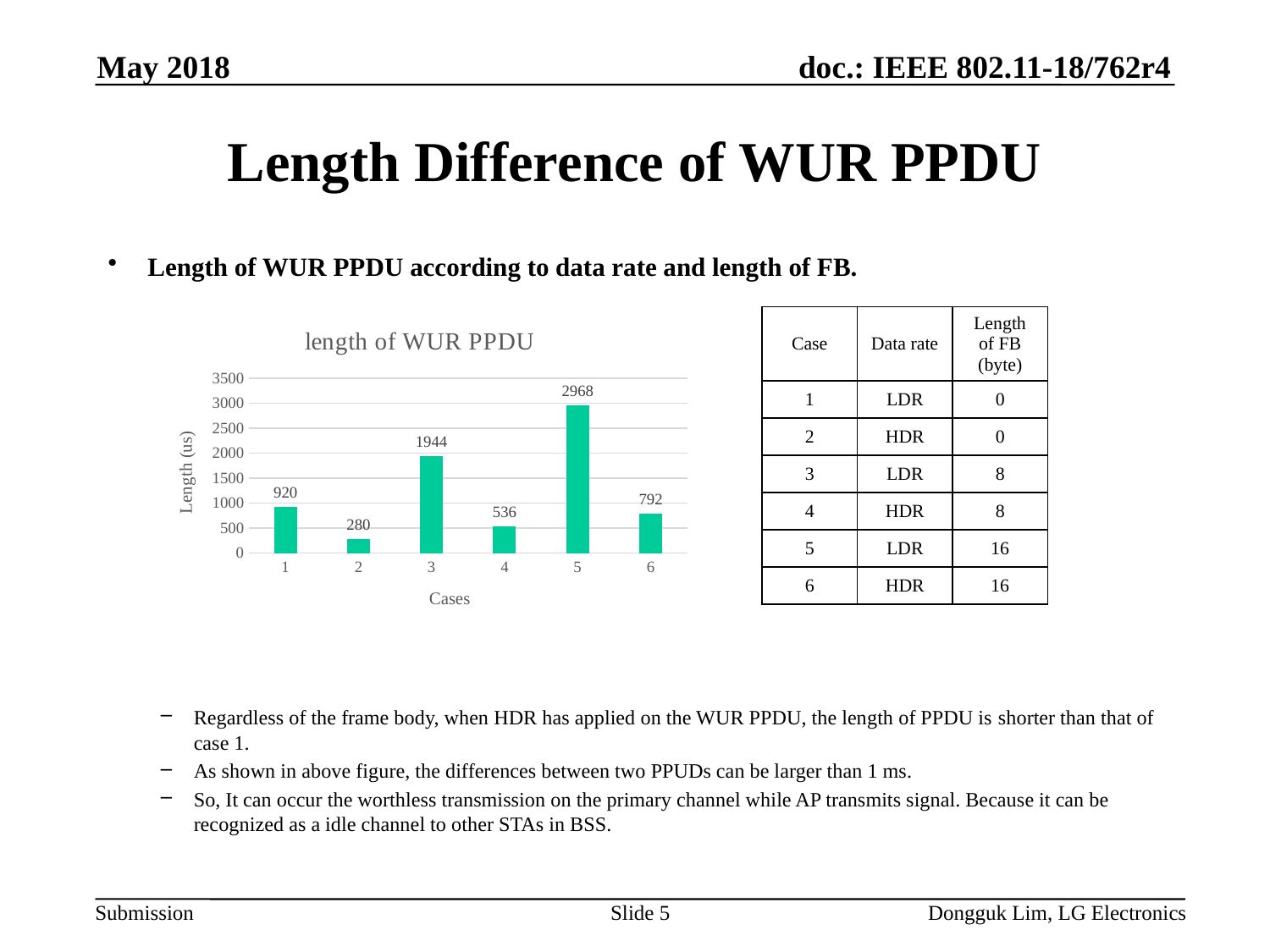
What is the length of WUR PPDU for case 3? 1944 What is the length of WUR PPDU for case 2? 280 Is the value for case 4 greater or less than 1000? less How many cases are plotted in the chart? 6 Which has a larger length of WUR PPDU, case 1 or case 6? case 1 What is the length of WUR PPDU for case 5? 2968 Which case has the lowest length of WUR PPDU? 2 What is the title of the chart? length of WUR PPDU Which case has the highest length of WUR PPDU? 5 What is the difference in length between case 5 and case 6? 2176 What is the difference in length between case 1 and case 2? 640 What kind of chart is shown on the slide? bar chart